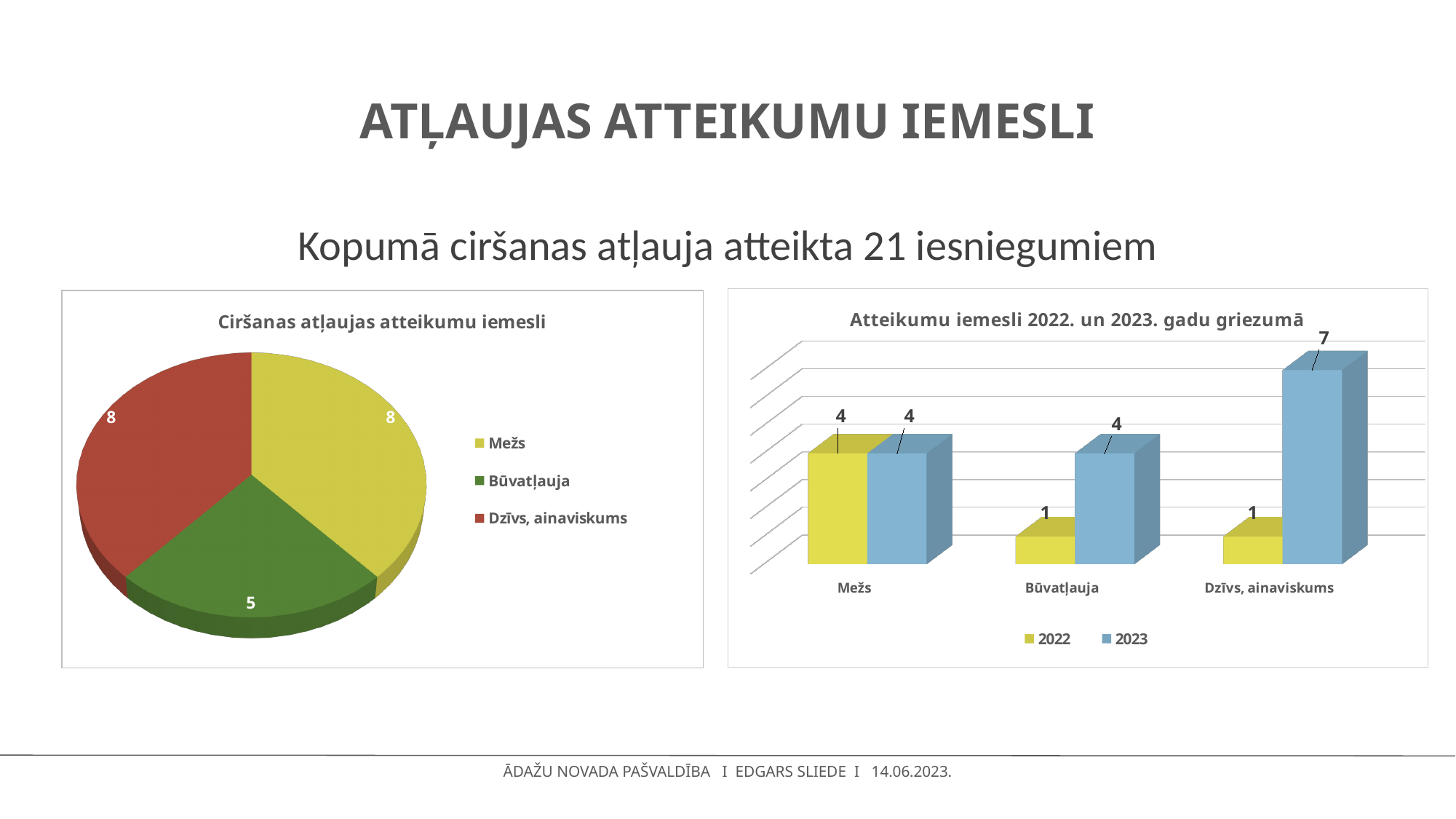
In the bar chart 'Atteikumu iemesli 2022. un 2023. gadu griezumā', which category has the highest value in 2023? Dzīvs, ainaviskums In the bar chart 'Atteikumu iemesli 2022. un 2023. gadu griezumā', what is the value for Būvatļauja in 2022? 1 In the pie chart 'Ciršanas atļaujas atteikumu iemesli', which category has the smallest slice? Būvatļauja In the pie chart 'Ciršanas atļaujas atteikumu iemesli', how many slices are there? 3 In the pie chart 'Ciršanas atļaujas atteikumu iemesli', what is the value for Mežs? 8 What kind of chart is the left chart, 'Ciršanas atļaujas atteikumu iemesli'? Pie chart In the bar chart 'Atteikumu iemesli 2022. un 2023. gadu griezumā', what is the value for Dzīvs, ainaviskums in 2023? 7 How many series does the legend of the bar chart 'Atteikumu iemesli 2022. un 2023. gadu griezumā' list? 2 In the pie chart 'Ciršanas atļaujas atteikumu iemesli', what is the value for Būvatļauja? 5 In the bar chart 'Atteikumu iemesli 2022. un 2023. gadu griezumā', which is larger for Būvatļauja: the 2022 value or the 2023 value? 2023 What kind of chart is the right chart, 'Atteikumu iemesli 2022. un 2023. gadu griezumā'? Bar chart In the bar chart 'Atteikumu iemesli 2022. un 2023. gadu griezumā', what is the difference between the 2023 and 2022 values for Dzīvs, ainaviskums? 6